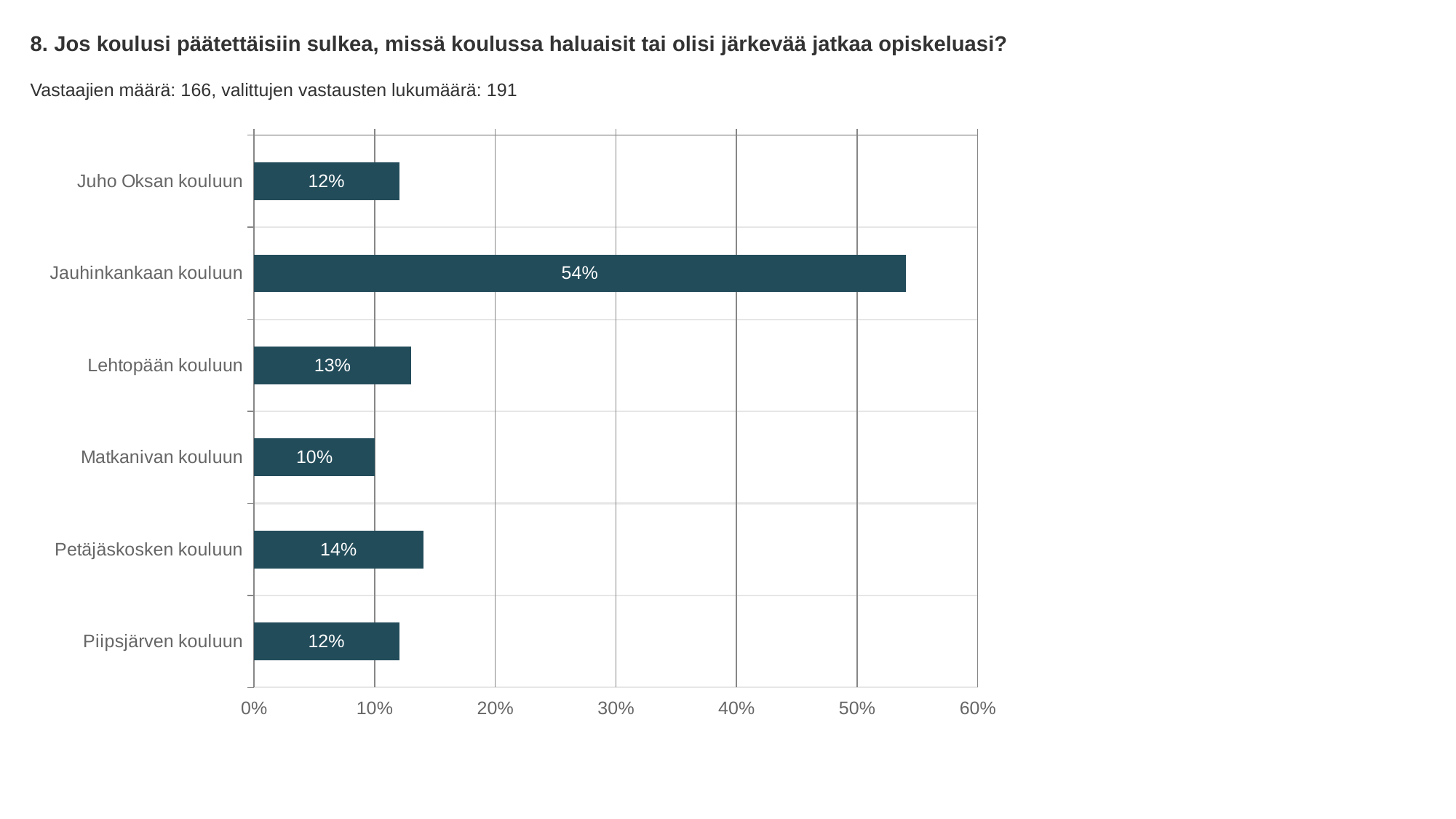
What is the difference between the values for Jauhinkankaan kouluun and Petäjäskosken kouluun? 40% What is the value for Petäjäskosken kouluun? 14% What kind of chart is shown on the slide? bar chart Which is larger, the value for Lehtopään kouluun or the value for Matkanivan kouluun? Lehtopään kouluun What is the value for Jauhinkankaan kouluun? 54% How many categories are shown in the chart? 6 Which category has the lowest value? Matkanivan kouluun What is the value for Lehtopään kouluun? 13% Which category has the highest value? Jauhinkankaan kouluun What is the number of respondents (Vastaajien määrä) stated on the slide? 166 Is the value for Jauhinkankaan kouluun greater or less than 50%? greater What is the value for Matkanivan kouluun? 10%